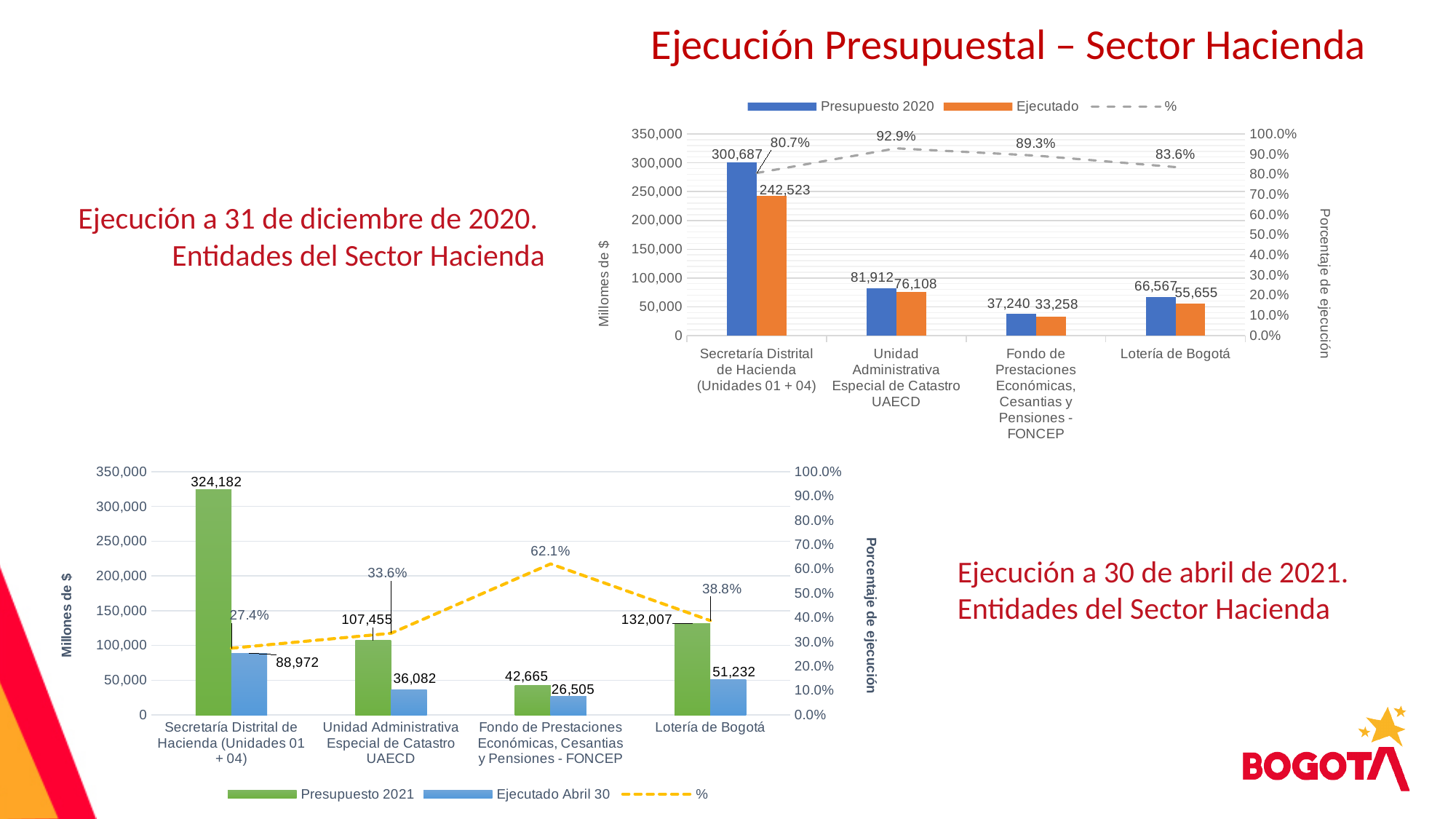
In the top-right chart (2020), what is the difference between Presupuesto 2020 and Ejecutado for Secretaría Distrital de Hacienda (Unidades 01 + 04)? 58,164 In the top-right chart (Ejecución a 31 de diciembre de 2020), what is the Presupuesto 2020 value for Secretaría Distrital de Hacienda (Unidades 01 + 04)? 300,687 In the bottom-left chart (2021), what is the execution percentage for Fondo de Prestaciones Económicas, Cesantias y Pensiones - FONCEP? 62.1% In the bottom-left chart (2021), what is the difference between Presupuesto 2021 and Ejecutado Abril 30 for Secretaría Distrital de Hacienda (Unidades 01 + 04)? 235,210 In the top-right chart (2020), which entity has the lowest Presupuesto 2020? Fondo de Prestaciones Económicas, Cesantias y Pensiones - FONCEP How many entities (categories) are shown on the x axis of the bottom-left chart (2021)? 4 How many series does the legend of the top-right chart (2020) list? 3 In the top-right chart (2020), what is the Ejecutado value for Lotería de Bogotá? 55,655 In the bottom-left chart (2021), which entity has the lowest execution percentage (%)? Secretaría Distrital de Hacienda (Unidades 01 + 04) In the top-right chart (2020), which entity has the highest execution percentage (%)? Unidad Administrativa Especial de Catastro UAECD In the bottom-left chart (Ejecución a 30 de abril de 2021), what is the Presupuesto 2021 value for Lotería de Bogotá? 132,007 In the bottom-left chart (2021), which is larger: the Ejecutado Abril 30 value for Unidad Administrativa Especial de Catastro UAECD or for Lotería de Bogotá? Lotería de Bogotá